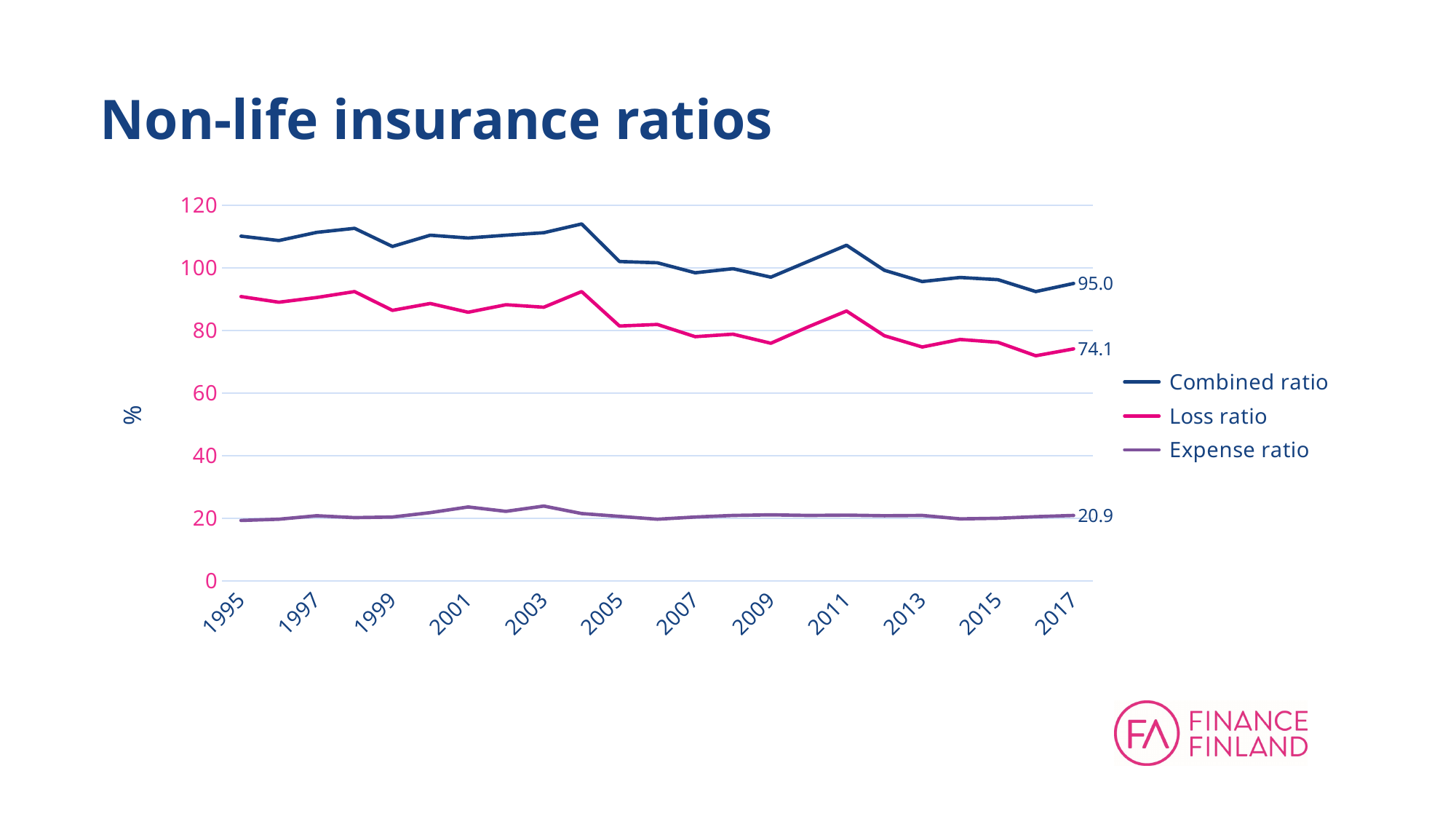
What is the Loss ratio value labelled for 2017? 74.1 Which series has the highest value in 2017? Combined ratio Which series has the lowest value in 2017? Expense ratio Is the Loss ratio in 2016 greater or less than 80? less What is the Expense ratio value labelled for 2017? 20.9 Is the Combined ratio in 2004 greater or less than 100? greater Does the Combined ratio overall rise or fall from 1995 to 2017? Fall What is the difference between the Combined ratio and the Loss ratio in 2017? 20.9 What kind of chart is shown on the slide? Line chart Is the Expense ratio in 2001 greater or less than 40? less How many series does the legend list? 3 What is the Combined ratio value labelled for 2017? 95.0